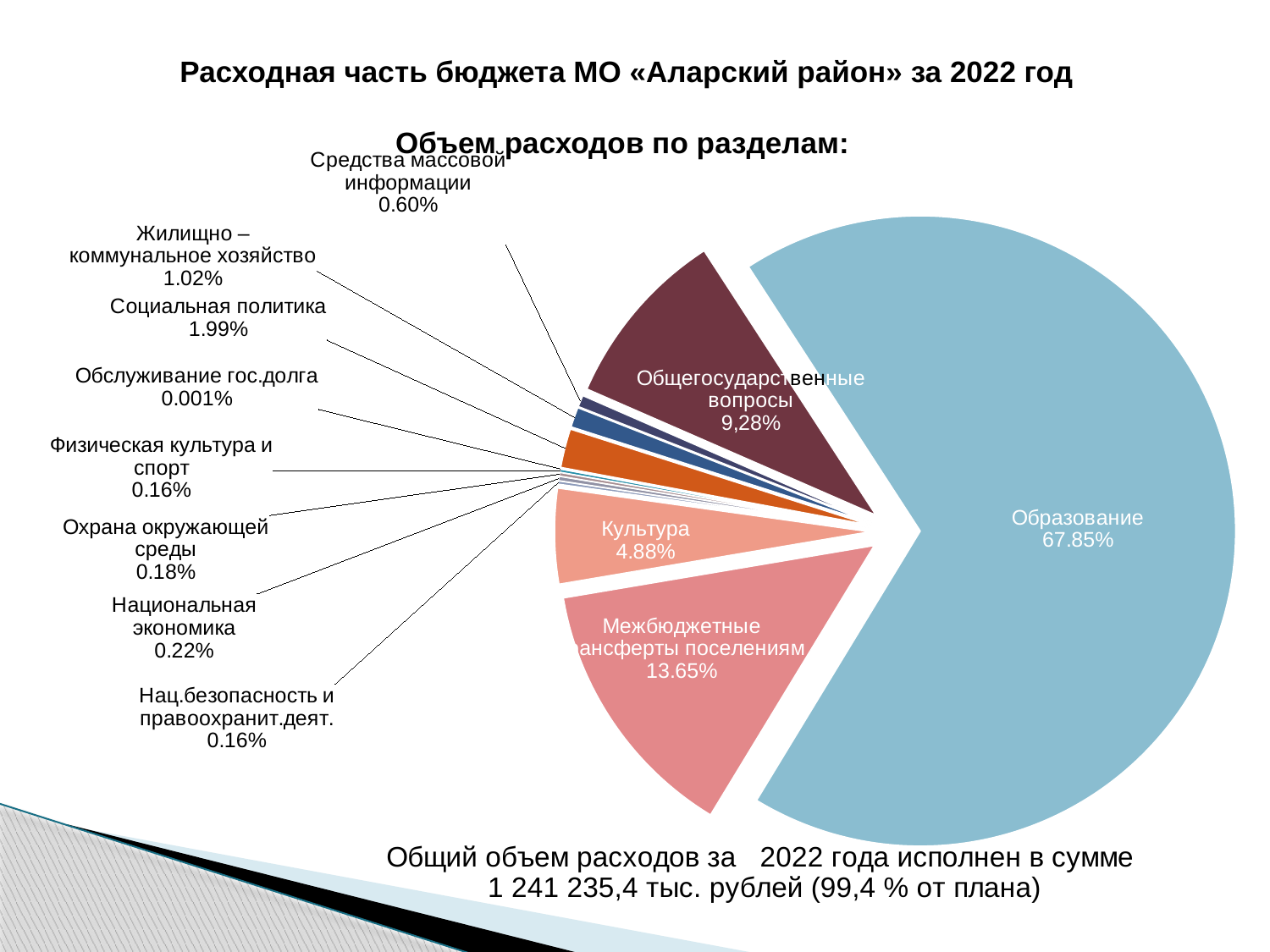
What is the share for Обслуживание гос.долга? 0.001% How many categories are shown in the pie chart? 12 Which category has the smallest share of the pie? Обслуживание гос.долга Which category has the largest share of the pie? Образование What is the share for Культура? 4.88% Which has a larger share, Культура or Социальная политика? Культура What is the share for Социальная политика? 1.99% What is the share for Межбюджетные трансферты поселениям? 13.65% What is the share for Общегосударственные вопросы? 9,28% What is the share for Образование? 67.85% What is the difference in percentage points between Образование and Межбюджетные трансферты поселениям? 54.20% What type of chart is shown on the slide? pie chart